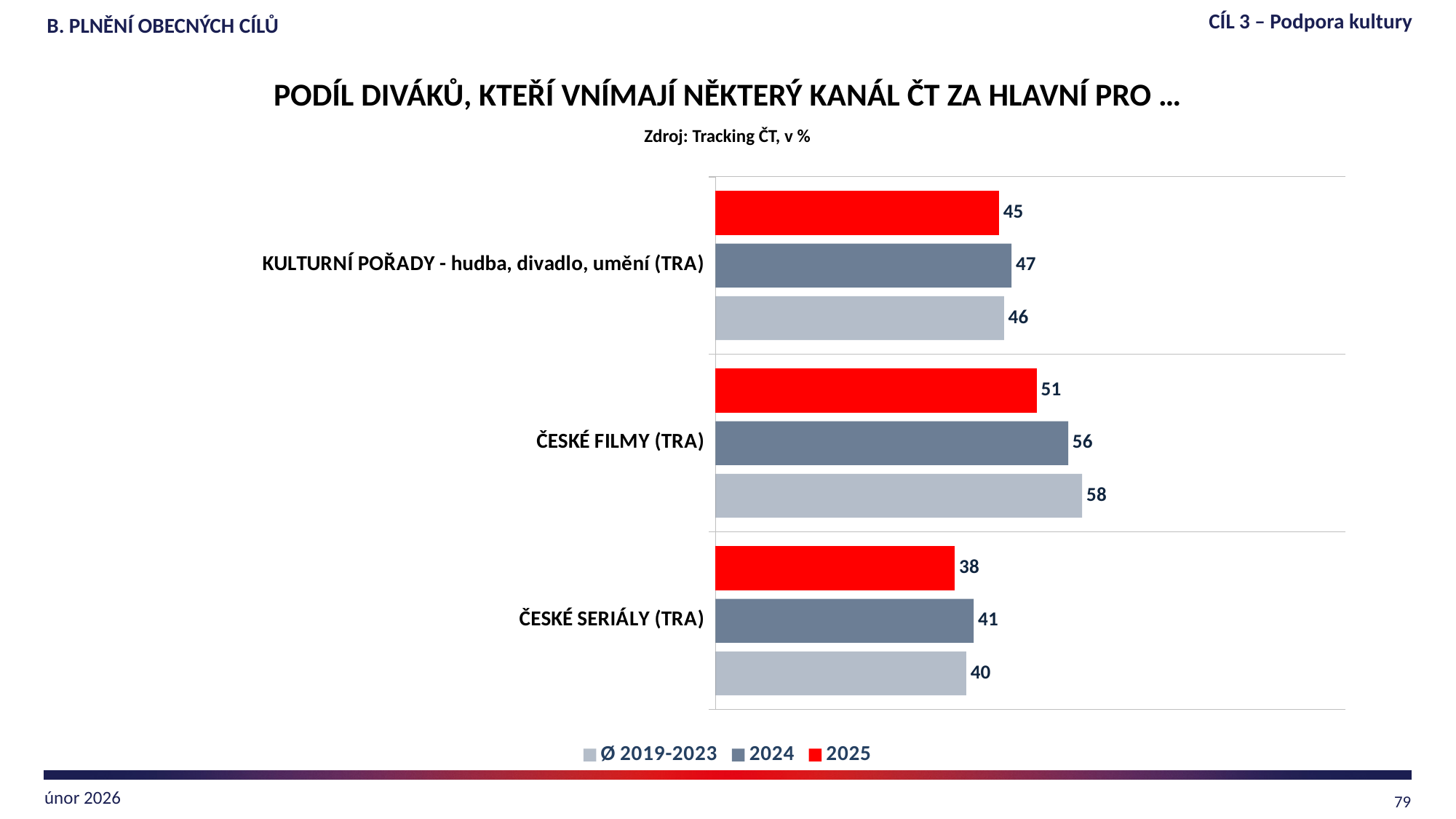
What is the 2024 value for KULTURNÍ POŘADY - hudba, divadlo, umění (TRA)? 47 What is the 2025 value for ČESKÉ FILMY (TRA)? 51 What kind of chart is shown on the slide? Bar chart Which category has the highest 2025 value? ČESKÉ FILMY (TRA) How many categories are shown on the chart? 3 Which series is shown in red? 2025 What is the source stated below the chart title? Tracking ČT, v % How many series does the legend list? 3 Which category has the lowest Ø 2019-2023 value? ČESKÉ SERIÁLY (TRA) What is the Ø 2019-2023 value for ČESKÉ SERIÁLY (TRA)? 40 Which is larger for ČESKÉ SERIÁLY (TRA): the 2024 value or the 2025 value? 2024 What is the difference between the Ø 2019-2023 and 2025 values for ČESKÉ FILMY (TRA)? 7